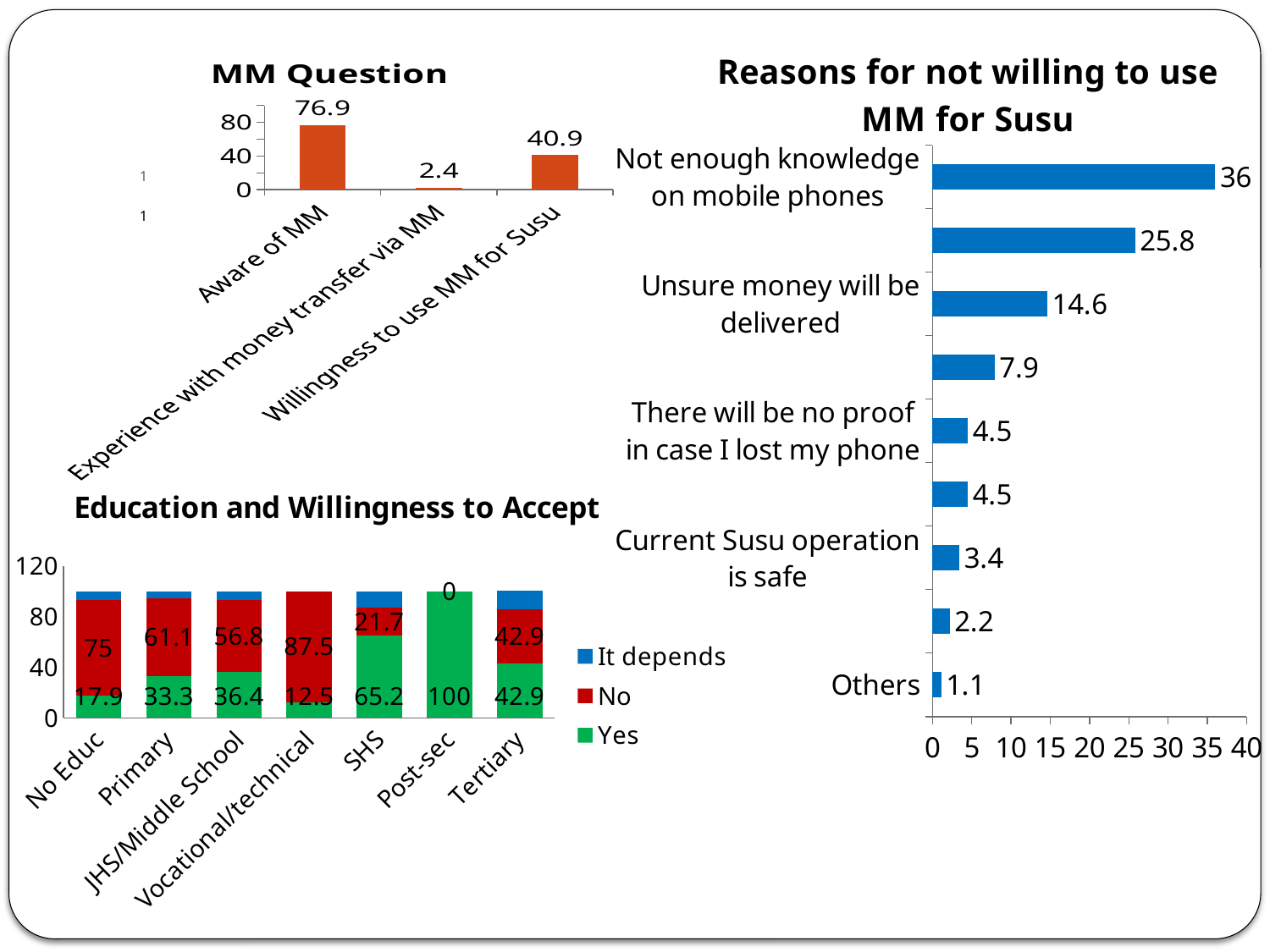
What kind of chart is the Reasons for not willing to use MM for Susu chart? Bar chart In the Reasons for not willing to use MM for Susu chart, what is the value for Not enough knowledge on mobile phones? 36 In the MM Question chart, what is the value for Aware of MM? 76.9 In the MM Question chart, what is the difference between Aware of MM and Willingness to use MM for Susu? 36 In the MM Question chart, which category has the highest value? Aware of MM In the Education and Willingness to Accept chart, is the Yes value for Primary or for JHS/Middle School larger? JHS/Middle School In the Education and Willingness to Accept chart, which education level has the highest Yes value? Post-sec In the Education and Willingness to Accept chart, how many series does the legend list? 3 In the Education and Willingness to Accept chart, what is the Yes value for SHS? 65.2 In the Education and Willingness to Accept chart, what is the No value for Vocational/technical? 87.5 In the Reasons for not willing to use MM for Susu chart, what is the value for Unsure money will be delivered? 14.6 In the MM Question chart, what is the value for Experience with money transfer via MM? 2.4